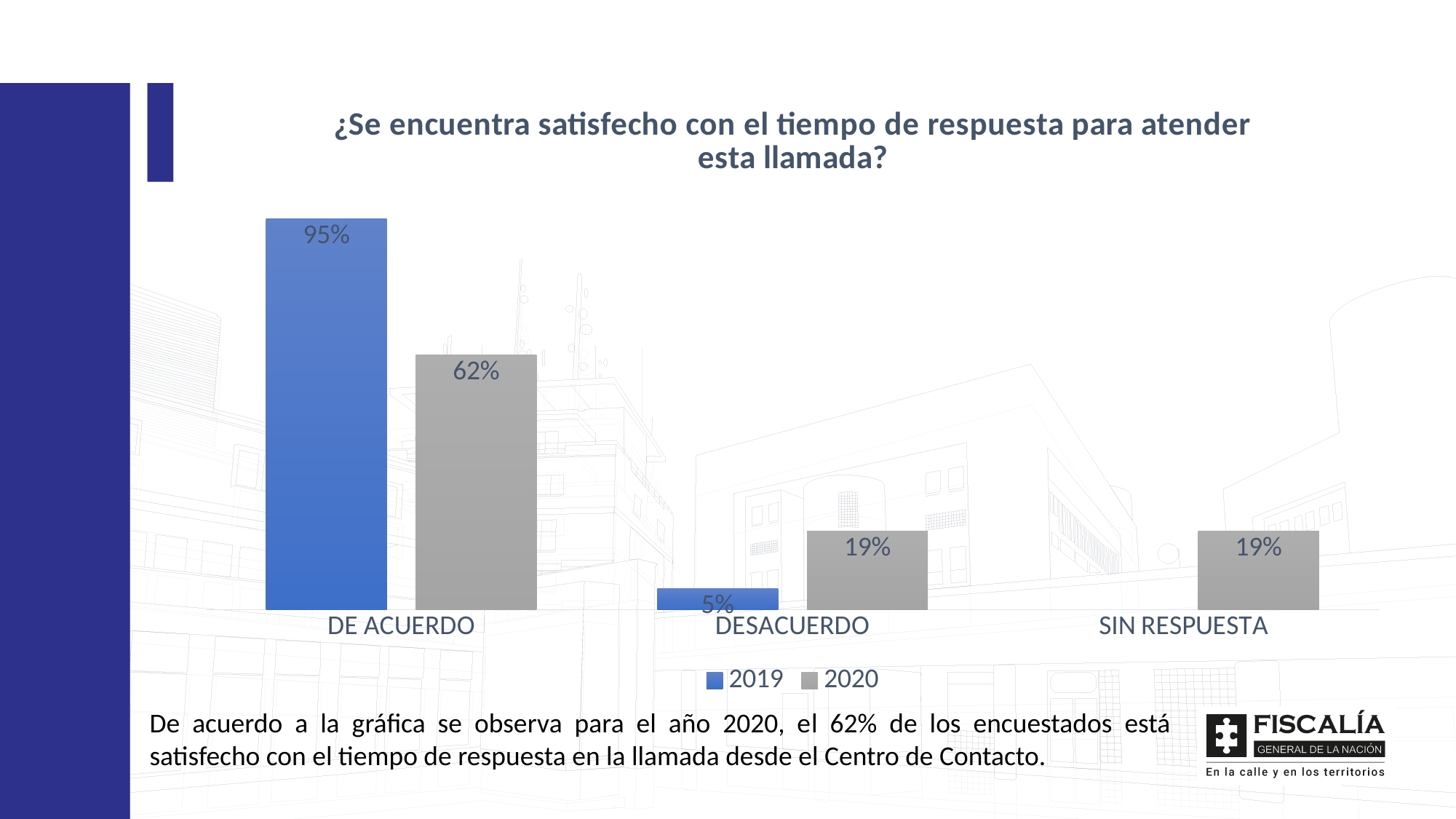
How many series does the legend list? 2 Which category has the lowest value in the 2019 series among those with a bar shown? DESACUERDO What is the value for SIN RESPUESTA in the 2020 series? 19% How many categories are shown on the x axis? 3 What is the value for DESACUERDO in the 2019 series? 5% What is the difference between the 2019 and 2020 values for DE ACUERDO? 33% What kind of chart is shown on the slide? Bar chart Which category has the highest value in the 2020 series? DE ACUERDO What is the value for DE ACUERDO in the 2020 series? 62% What is the difference between the 2020 values for DE ACUERDO and DESACUERDO? 43% Which is larger for DESACUERDO, the 2019 value or the 2020 value? 2020 What is the value for DE ACUERDO in the 2019 series? 95%